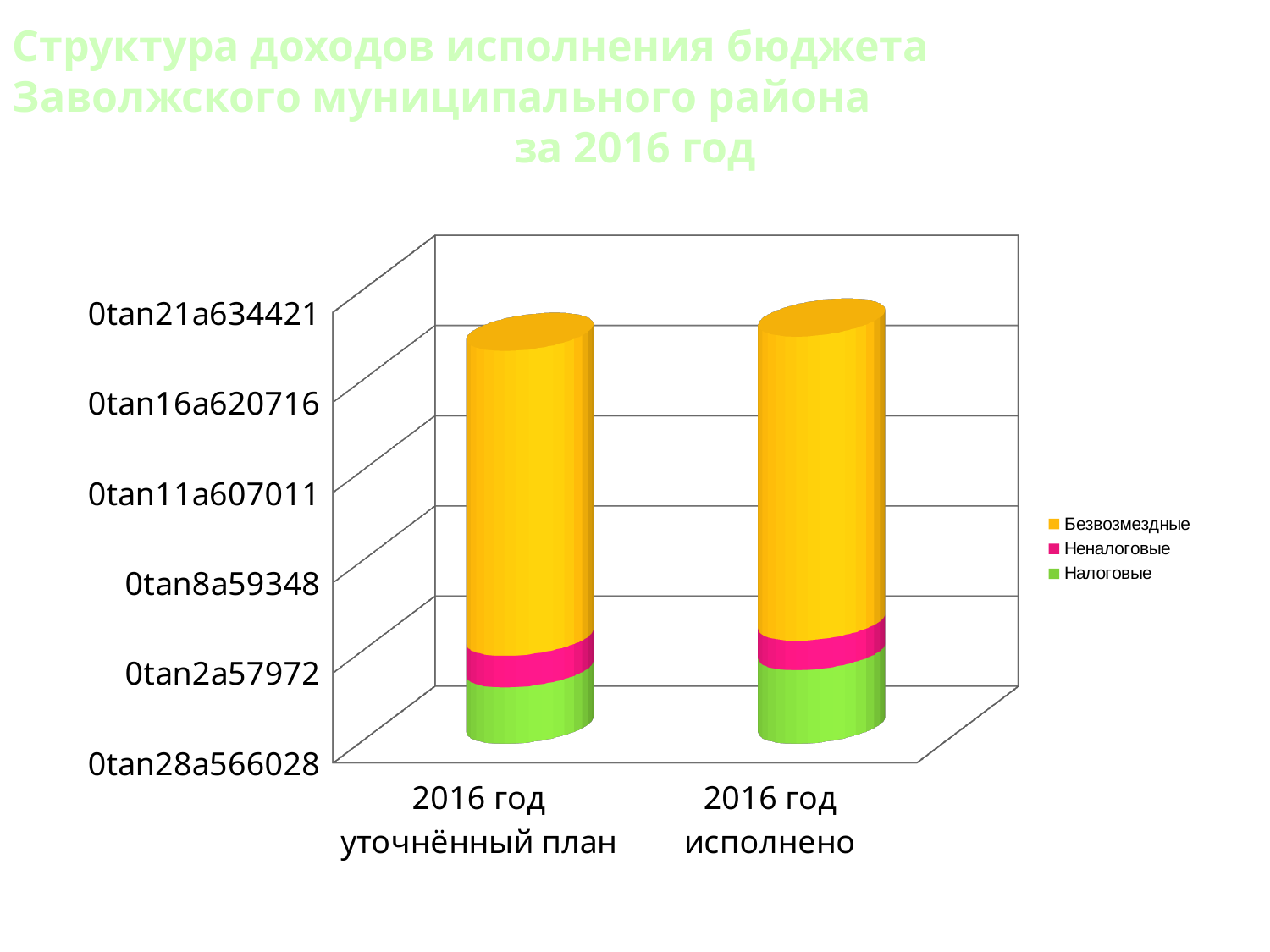
How many series does the chart legend list? 3 In the bar for "2016 год исполнено", which is larger: the Безвозмездные segment or the Налоговые segment? Безвозмездные What are the names of the series listed in the chart legend? Безвозмездные, Неналоговые, Налоговые How many categories are shown on the x axis of the chart? 2 Which series makes up the largest part of the bar for "2016 год уточнённый план"? Безвозмездные Which series makes up the largest part of the bar for "2016 год исполнено"? Безвозмездные Which series makes up the smallest part of the bar for "2016 год уточнённый план"? Неналоговые What kind of chart is shown on the slide? Stacked bar chart Which series is shown at the bottom of each stacked bar? Налоговые In the bar for "2016 год уточнённый план", which is larger: the Неналоговые segment or the Безвозмездные segment? Безвозмездные What are the two category labels on the x axis of the chart? 2016 год уточнённый план; 2016 год исполнено